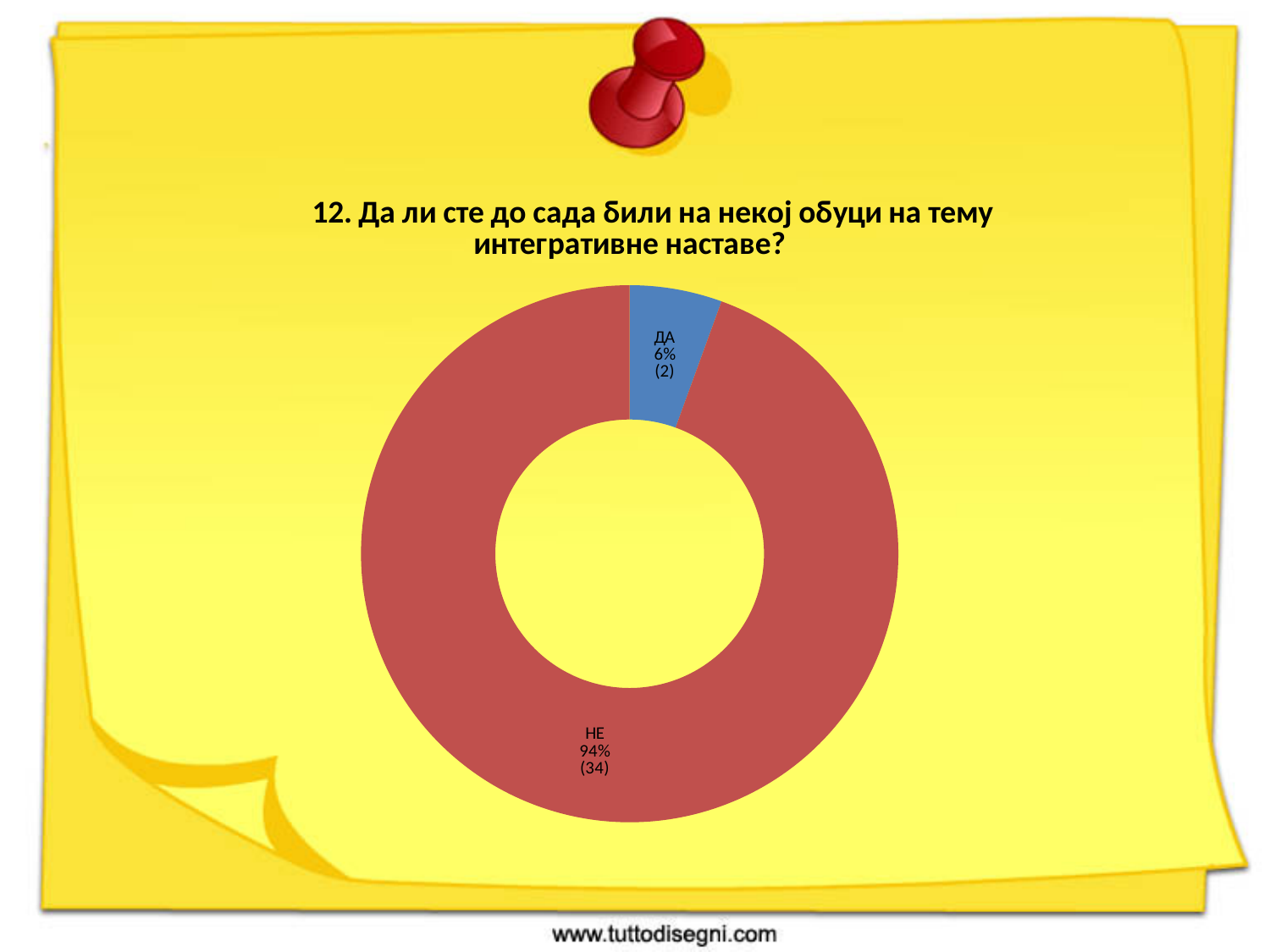
How many categories are shown in the chart? 2 What percentage of respondents answered НЕ? 94% Which answer has the largest share of the chart? НЕ Which answer has the smallest share of the chart? ДА What percentage of respondents answered ДА? 6% Which is larger, the share for ДА or the share for НЕ? НЕ What colour is the ДА segment of the chart? Blue What is the difference in percentage points between НЕ and ДА? 88 How many more respondents answered НЕ than ДА? 32 How many respondents answered НЕ? 34 What kind of chart is shown on the slide? Doughnut chart How many respondents answered ДА? 2